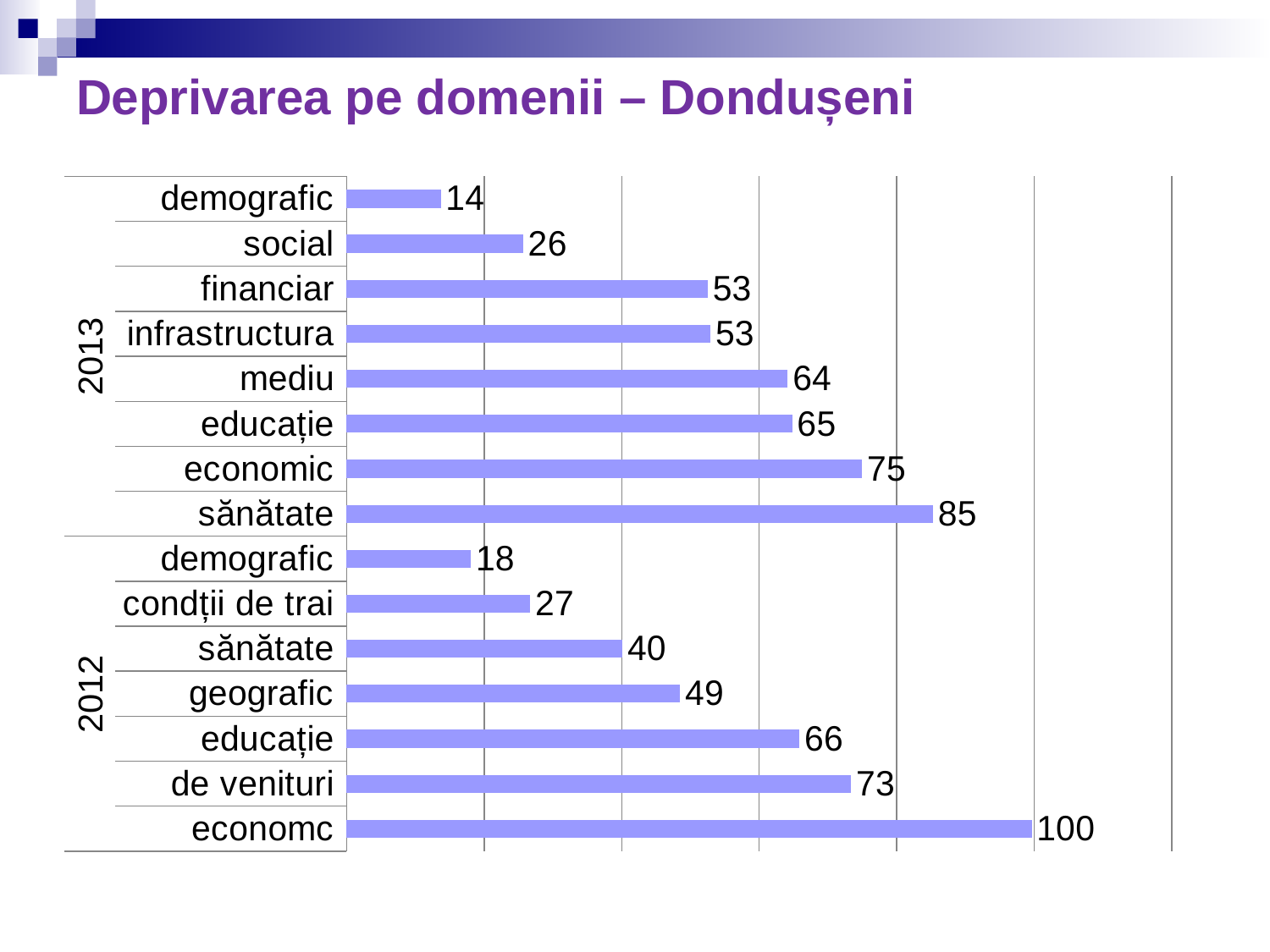
How many categories are shown for 2013? 8 How many bars are plotted in the chart in total? 15 Which category has the highest value in the 2012 group? economc What is the difference between economic in 2013 and sănătate in 2013? 10 What is the value for demografic in 2012? 18 What is the title of the slide? Deprivarea pe domenii – Dondușeni What is the value for de venituri in 2012? 73 Which category has the lowest value in the 2013 group? demografic What is the value for sănătate in 2013? 85 Which is larger, social in 2013 or condții de trai in 2012? condții de trai in 2012 What is the difference between educație in 2012 and educație in 2013? 1 What kind of chart is shown on the slide? bar chart